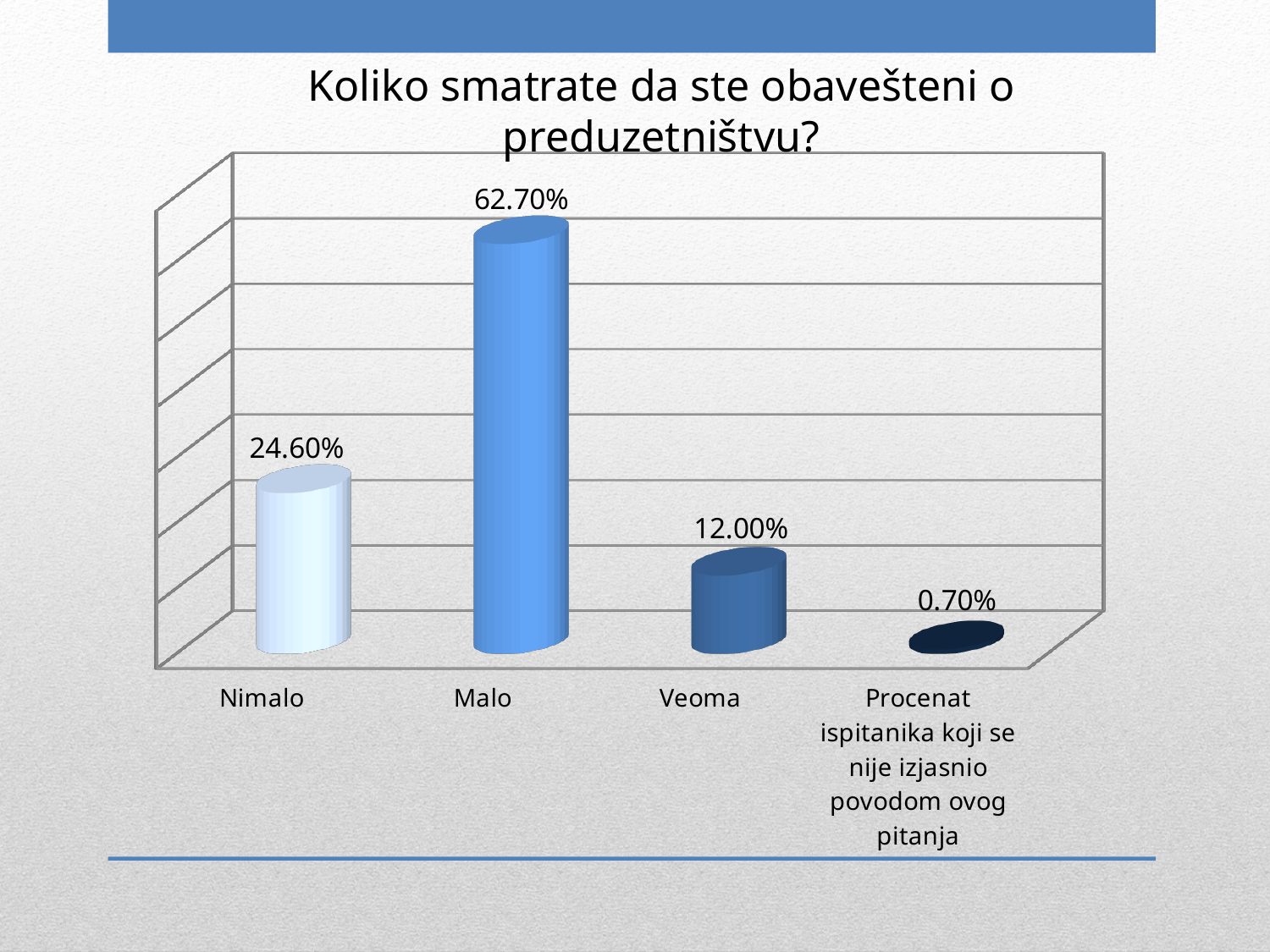
What is the difference between the values for Malo and Nimalo? 38.10% Which is larger, the value for Nimalo or the value for Veoma? Nimalo What is the value for Malo? 62.70% What is the value for Veoma? 12.00% What is the value for the category 'Procenat ispitanika koji se nije izjasnio povodom ovog pitanja'? 0.70% Which category has the highest value? Malo What kind of chart is shown on the slide? Bar chart What is the value for Nimalo? 24.60% How many categories are shown in the chart? 4 What is the title of the chart? Koliko smatrate da ste obavešteni o preduzetništvu? What is the difference between the values for Nimalo and Veoma? 12.60% Which category has the lowest value? Procenat ispitanika koji se nije izjasnio povodom ovog pitanja